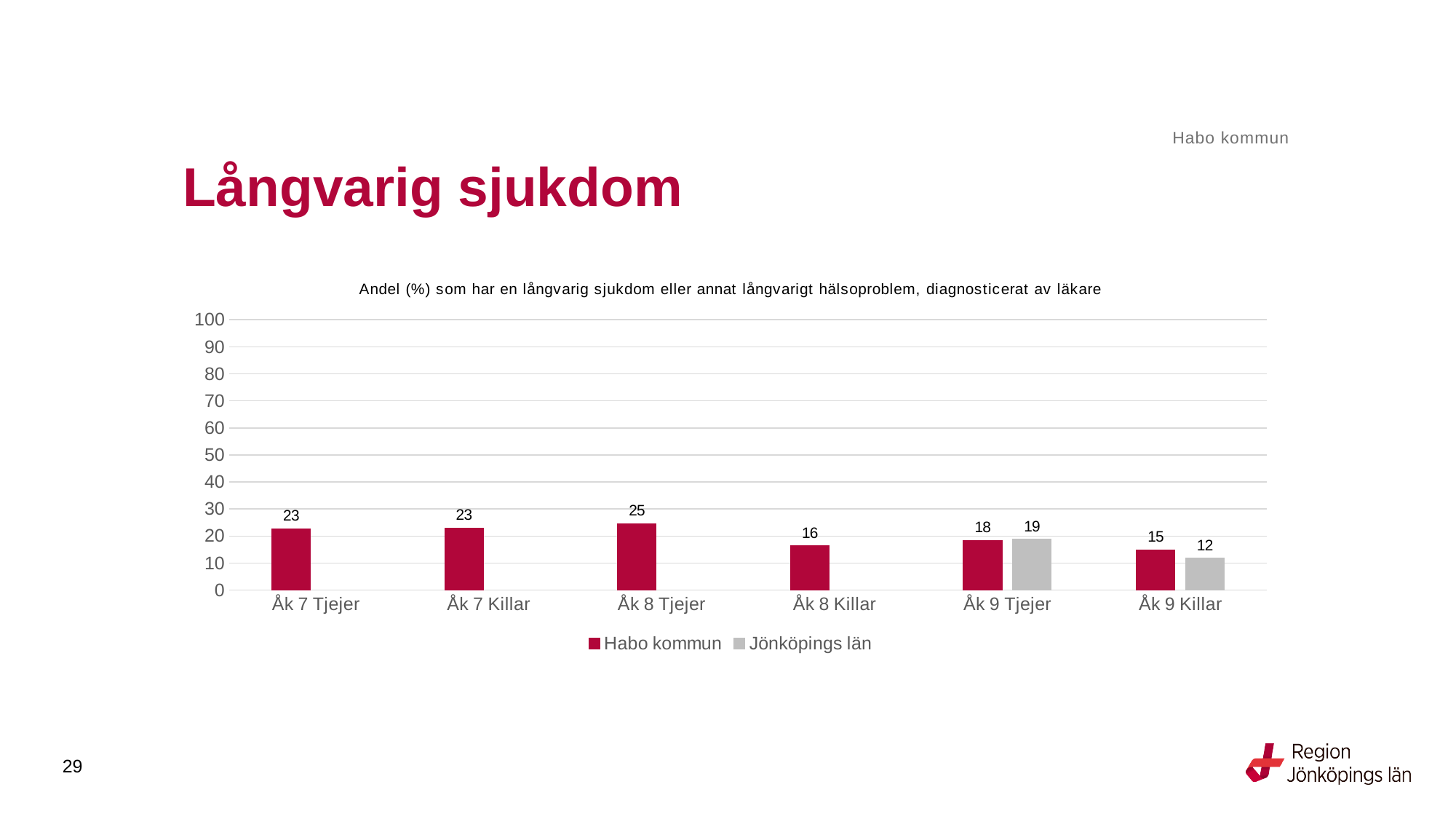
For Åk 9 Tjejer, which is larger: Habo kommun or Jönköpings län? Jönköpings län Is the Habo kommun value for Åk 7 Tjejer greater or less than 30? less How many categories are shown on the x axis? 6 What is the difference between the Habo kommun and Jönköpings län values for Åk 9 Killar? 3 Which category has the lowest Habo kommun value? Åk 9 Killar What is the value for Habo kommun for Åk 8 Killar? 16 How many series does the legend list? 2 Which category has the highest Habo kommun value? Åk 8 Tjejer What is the value for Habo kommun for Åk 8 Tjejer? 25 What is the difference between the Habo kommun values for Åk 8 Tjejer and Åk 8 Killar? 9 What kind of chart is shown on the slide? bar chart What is the value for Jönköpings län for Åk 9 Killar? 12